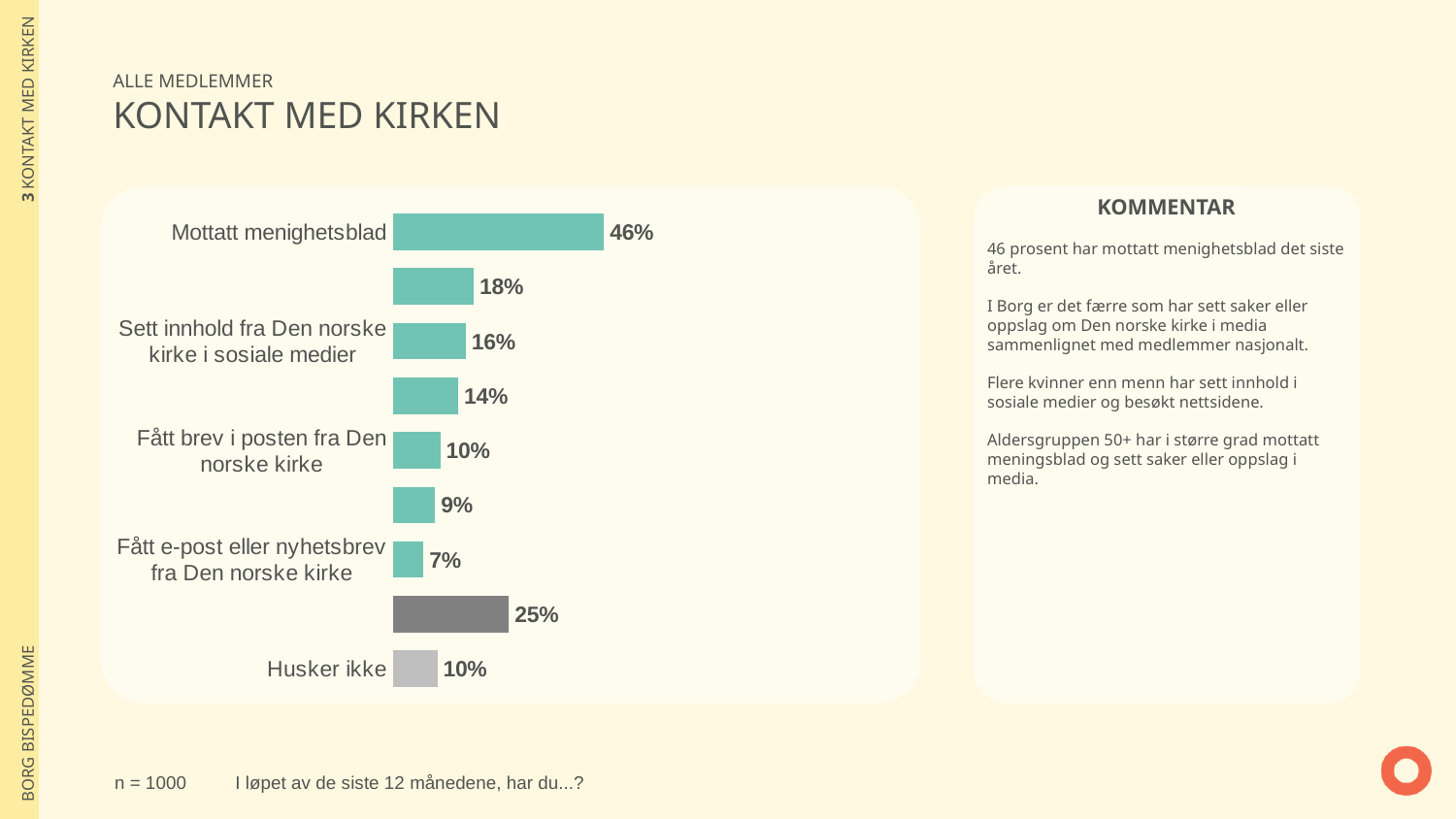
How many bars are plotted in the chart? 9 What is the difference in percentage points between "Mottatt menighetsblad" and "Husker ikke"? 36 percentage points What kind of chart is shown on the slide? Bar chart What is the value for "Mottatt menighetsblad"? 46% What is the title of the slide containing the chart? KONTAKT MED KIRKEN What is the value for "Husker ikke"? 10% What is the value for "Fått e-post eller nyhetsbrev fra Den norske kirke"? 7% What is the value for "Sett innhold fra Den norske kirke i sosiale medier"? 16% What is the value for "Fått brev i posten fra Den norske kirke"? 10% Which labelled category has the lowest value? Fått e-post eller nyhetsbrev fra Den norske kirke Which category has the highest value? Mottatt menighetsblad Which is larger: "Sett innhold fra Den norske kirke i sosiale medier" or "Fått brev i posten fra Den norske kirke"? Sett innhold fra Den norske kirke i sosiale medier